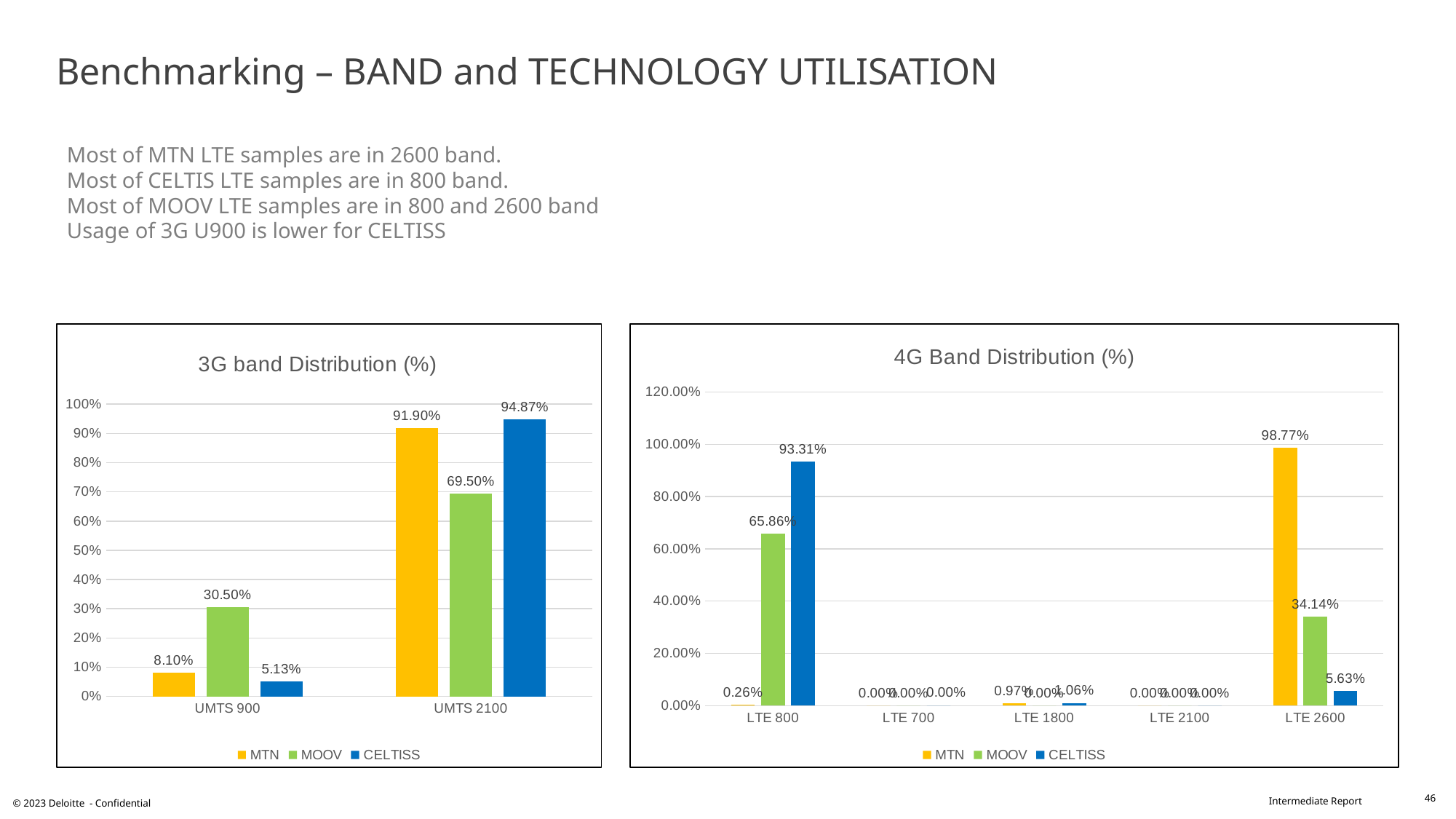
In the 4G Band Distribution (%) chart, what is the value for CELTISS at LTE 800? 93.31% How many band categories are shown on the x axis of the 4G Band Distribution (%) chart? 5 How many series does the legend of the 3G band Distribution (%) chart list? 3 In the 4G Band Distribution (%) chart, what is the value for MTN at LTE 2600? 98.77% In the 4G Band Distribution (%) chart, which operator has the highest value at LTE 800? CELTISS In the 3G band Distribution (%) chart, what is the value for CELTISS at UMTS 2100? 94.87% In the 4G Band Distribution (%) chart, which is larger: MOOV at LTE 2600 or CELTISS at LTE 2600? MOOV at LTE 2600 In the 4G Band Distribution (%) chart, what is the difference between the MOOV values at LTE 800 and LTE 2600? 31.72% In the 3G band Distribution (%) chart, which operator has the highest value at UMTS 2100? CELTISS In the 3G band Distribution (%) chart, what is the difference between the MTN values at UMTS 2100 and UMTS 900? 83.80% In the 3G band Distribution (%) chart, what is the value for MOOV at UMTS 900? 30.50% In the 3G band Distribution (%) chart, which operator has the lowest value at UMTS 900? CELTISS